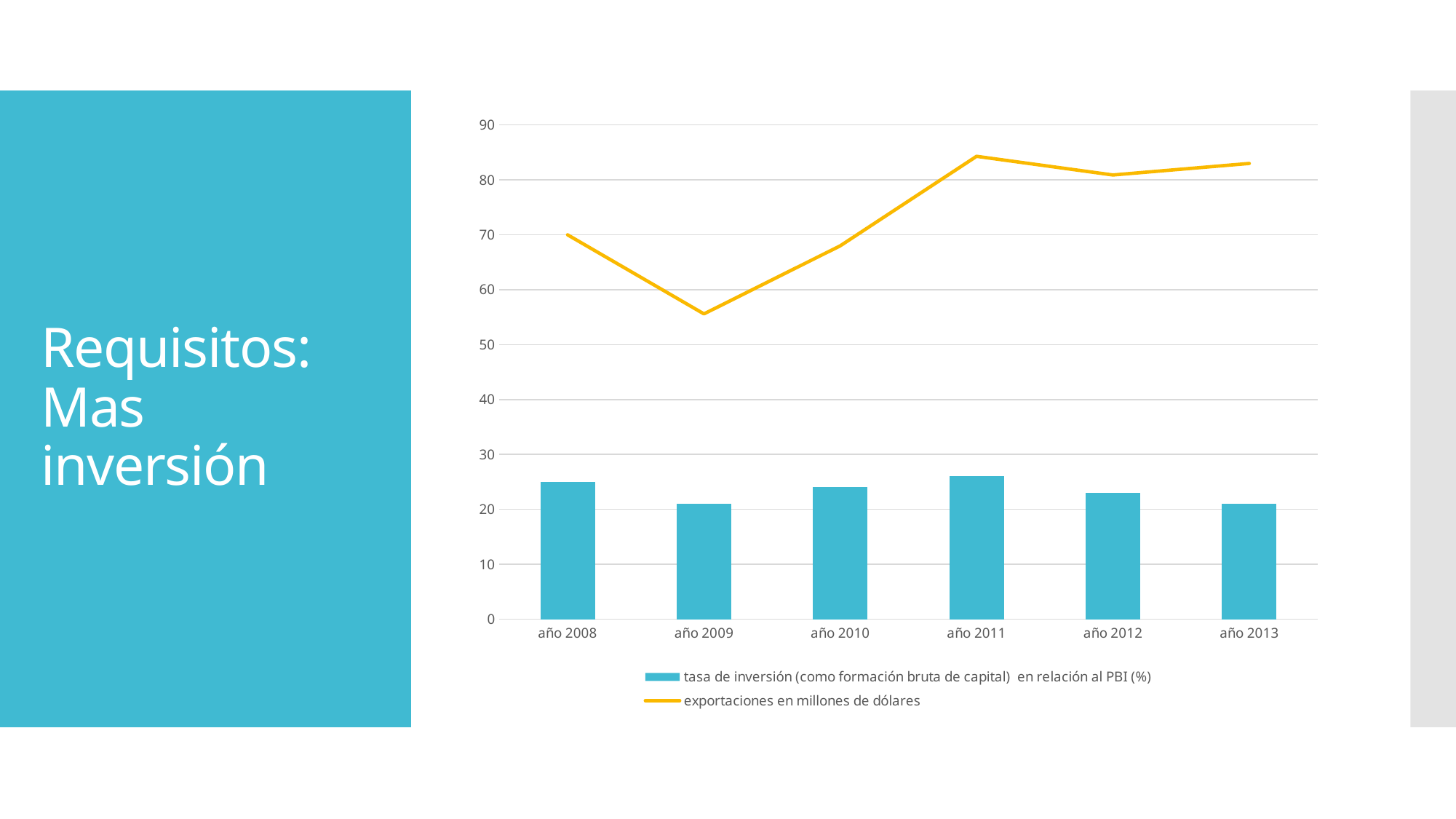
Which is larger, the 'tasa de inversión' bar for año 2009 or for año 2011? año 2011 How many years are shown on the x axis of the chart? 6 Is the value of 'exportaciones en millones de dólares' for año 2011 greater or less than 80? greater What kind of chart is shown on the slide? A combined bar and line chart In which year is the value of 'exportaciones en millones de dólares' lowest? año 2009 Is the 'tasa de inversión' bar for año 2008 greater or less than 20? greater Is the value of 'exportaciones en millones de dólares' for año 2009 greater or less than 60? less How many series does the chart legend list? 2 Does the 'exportaciones en millones de dólares' line rise or fall from año 2009 to año 2011? rise Which is larger, the 'exportaciones en millones de dólares' value for año 2008 or for año 2011? año 2011